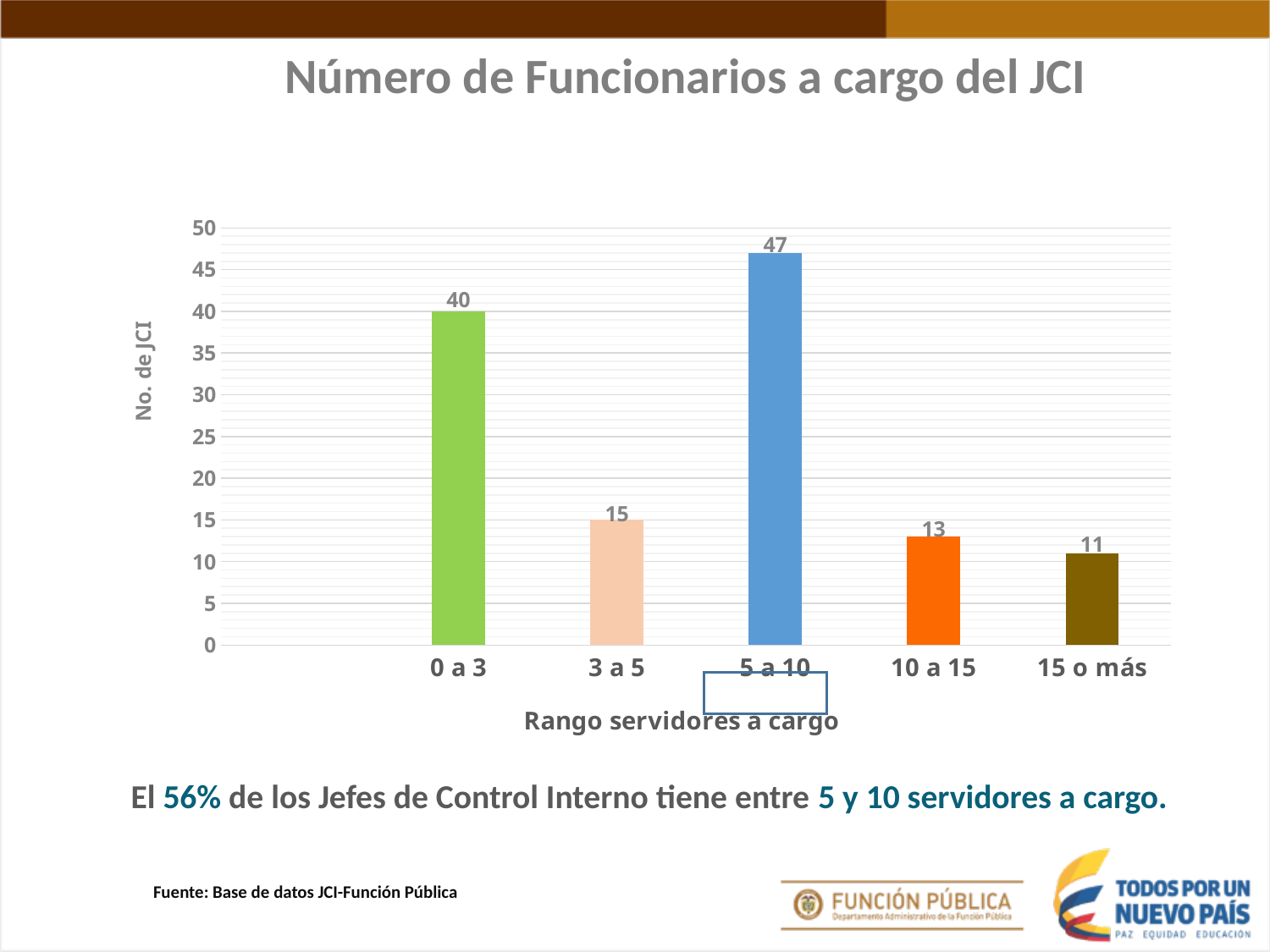
Which category has the lowest value? 15 o más What is the value for the '15 o más' category? 11 What is the title of the y axis? No. de JCI Which is larger, the value for '3 a 5' or the value for '10 a 15'? 3 a 5 What is the value for the '5 a 10' category? 47 Is the value for '0 a 3' greater or less than 35? greater What is the difference between the values for '5 a 10' and '0 a 3'? 7 What is the difference between the values for '3 a 5' and '10 a 15'? 2 Which category has the highest value? 5 a 10 How many categories are shown on the x axis? 5 What kind of chart is shown on the slide? bar chart What is the value for the '0 a 3' category? 40